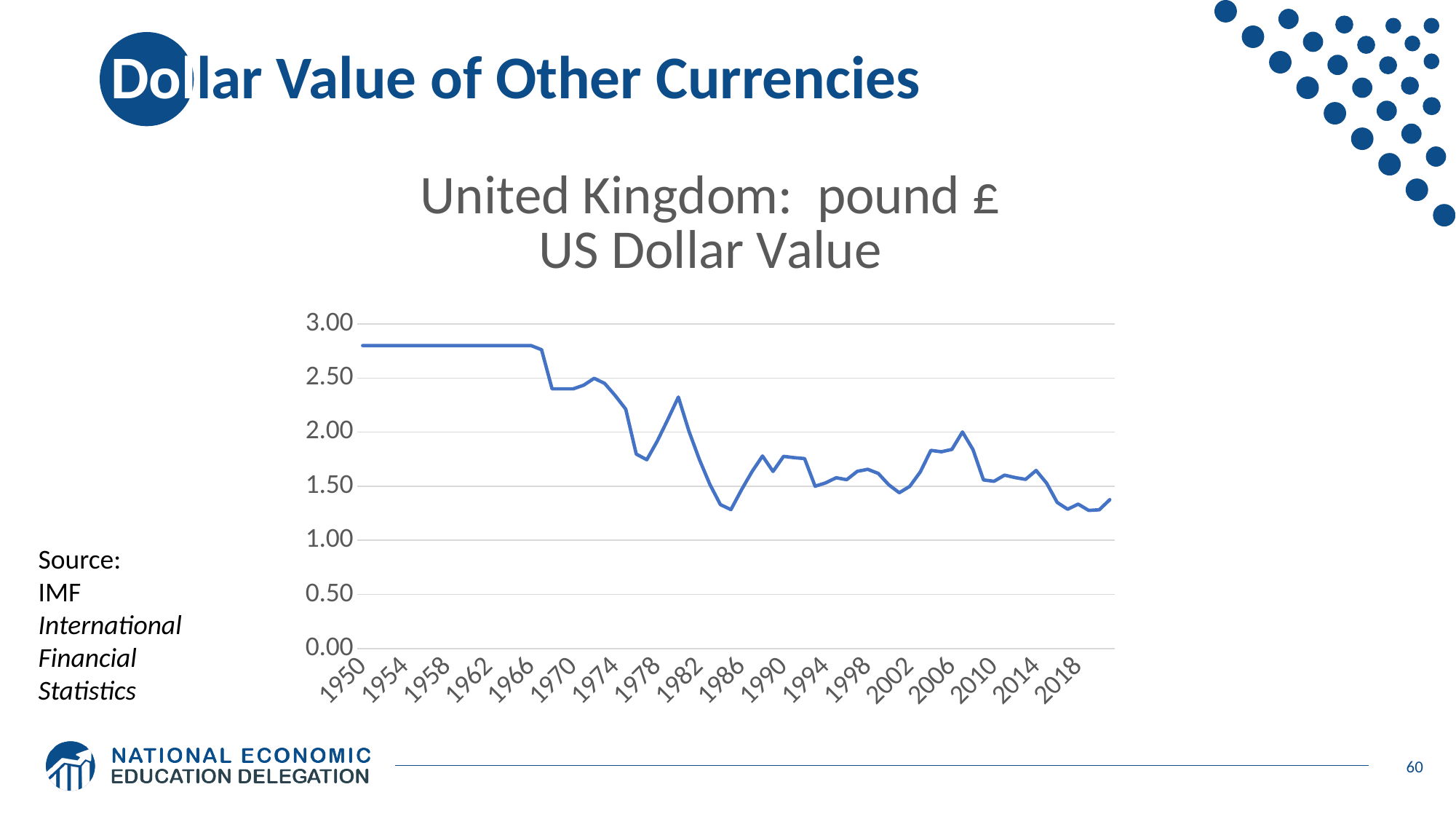
Is the value for 1970 greater or less than 2.00? greater How many year labels are shown on the x axis? 18 Is the value for 1978 greater or less than 1.50? greater What is the title of the chart? United Kingdom: pound £ US Dollar Value Is the value for 2018 greater or less than 1.50? less What is the highest value shown on the y axis? 3.00 Overall, does the US dollar value of the pound rise or fall from 1950 to 2018? fall Which year has the larger value, 1950 or 2018? 1950 What kind of chart is shown on the slide? line chart